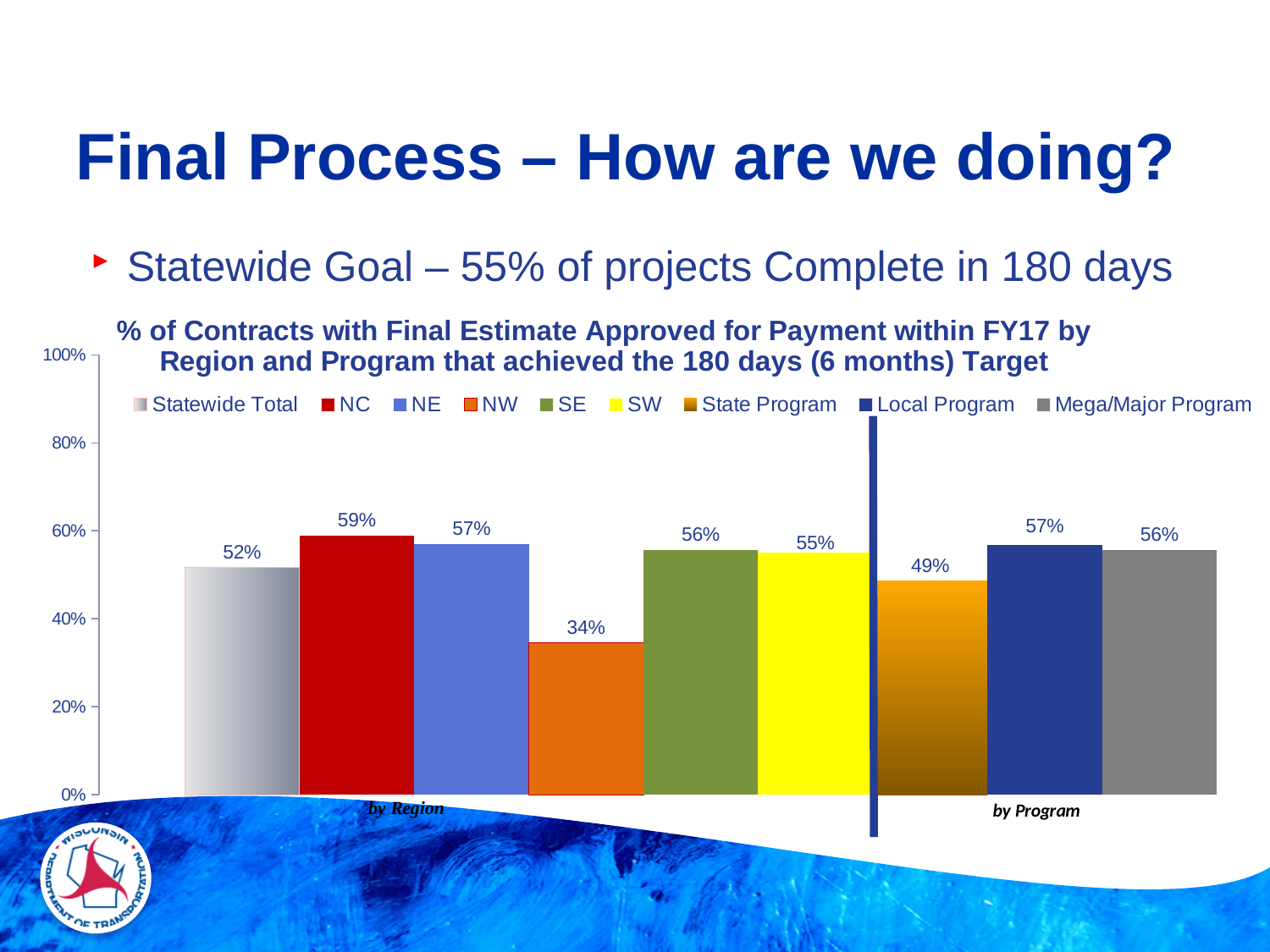
What is the difference between the values for NC and NW? 25% Which series has the lowest value? NW Which series has the highest value? NC What is the value for NW? 34% What is the value for NC? 59% Is the value for NW greater or less than 40%? less How many series does the legend list? 9 What kind of chart is shown on the slide? bar chart What colour is the bar for SW? yellow What is the value for Statewide Total? 52% Which is larger, the value for SE or the value for State Program? SE What is the value for State Program? 49%